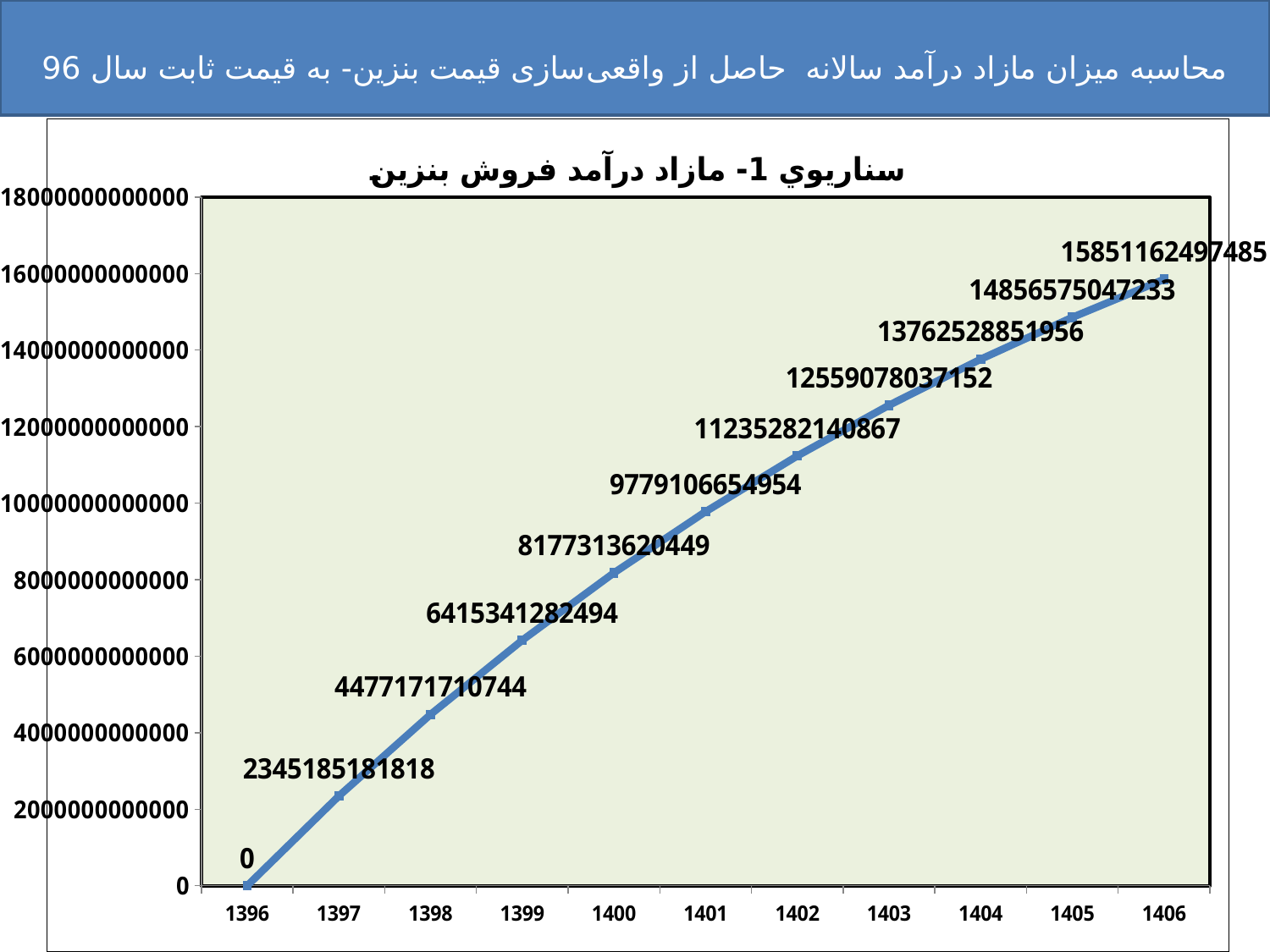
Which is larger, the value for 1401 or the value for 1402? 1402 What is the difference between the values for 1406 and 1405? 994587450252 How many data points are plotted on the chart? 11 Which year has the highest value? 1406 What is the value for 1403? 12559078037152 What kind of chart is shown? line chart What is the difference between the values for 1398 and 1397? 2131986528926 Do the values rise or fall from 1396 to 1406? rise Which year has the lowest value? 1396 What is the value for 1400? 8177313620449 What is the value for 1406? 15851162497485 What is the value for 1397? 2345185181818